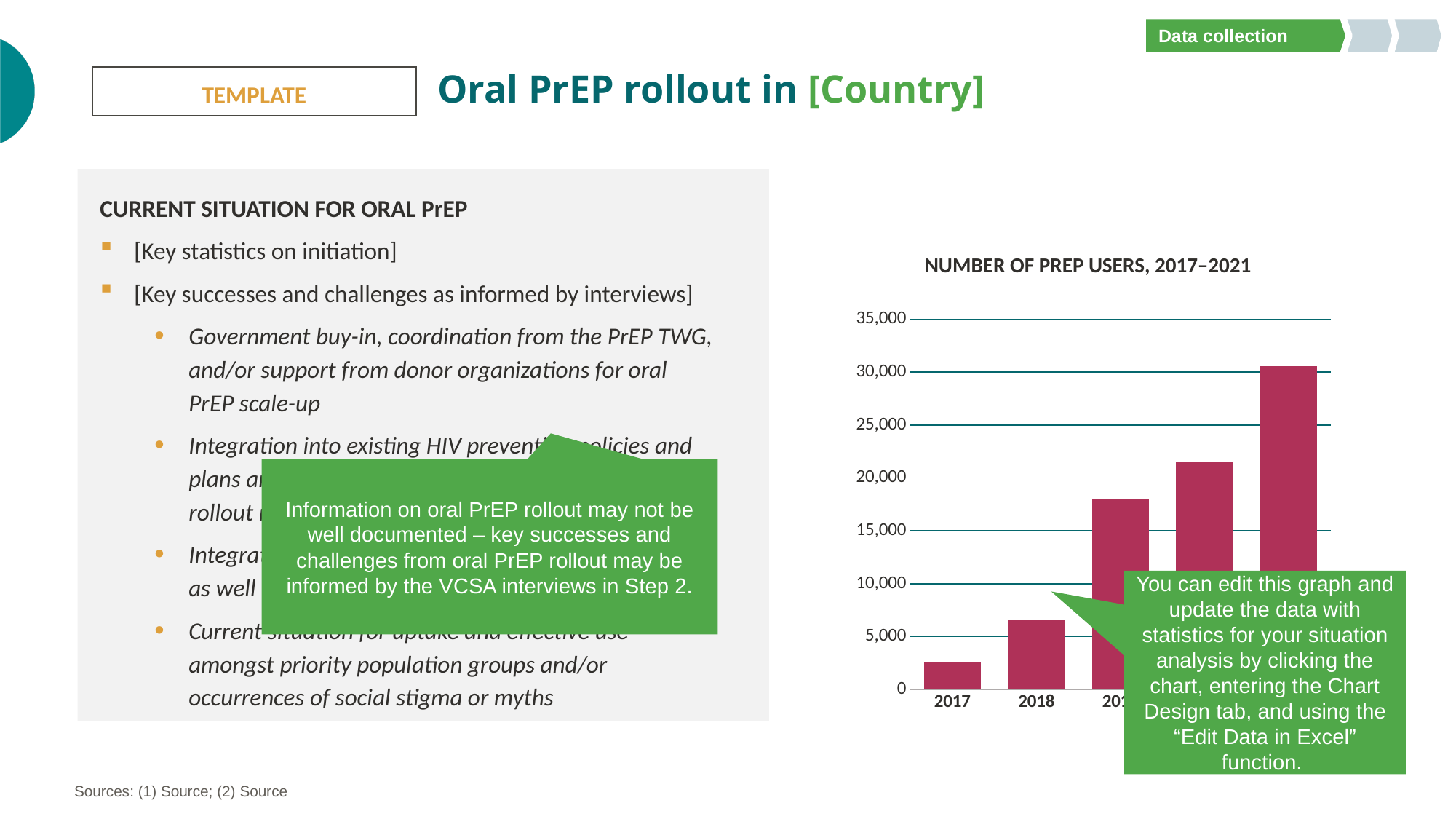
How many bars are plotted in the chart? 5 Which year has the larger number of PrEP users, 2017 or 2018? 2018 Do the values in the chart rise or fall from left to right along the x axis? Rise Is the value for 2018 greater or less than 10,000? less Which year has the lowest number of PrEP users in the chart? 2017 What type of chart is shown on the slide? Bar chart What is the title of the chart on the slide? NUMBER OF PREP USERS, 2017–2021 Is the value for 2017 greater or less than 10,000? less What is the highest value shown on the chart's y axis? 35,000 Is the value for 2017 greater or less than 5,000? less